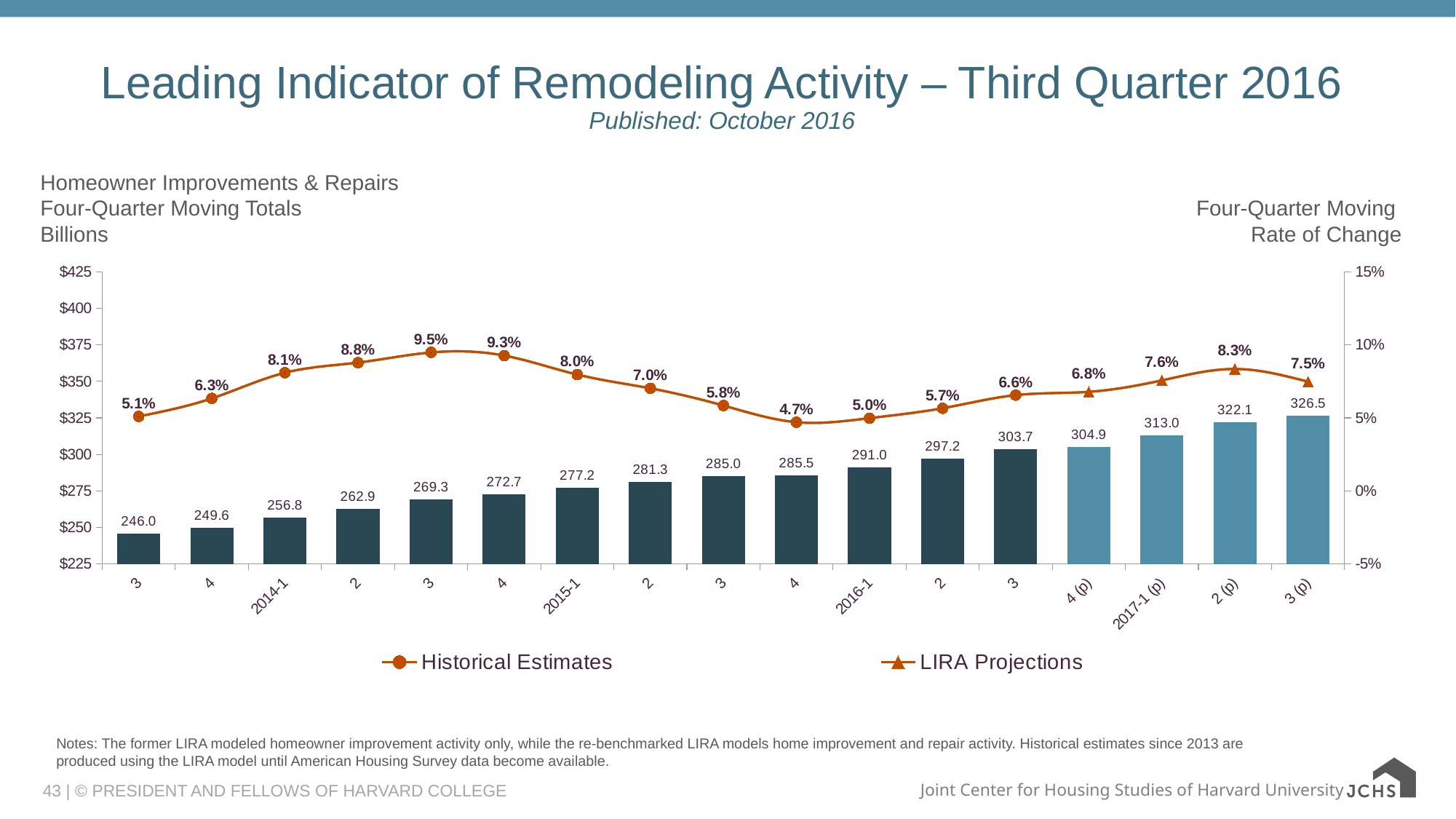
Which is larger, the rate of change for 2015-1 or for 2 (p)? 2 (p) Do the four-quarter moving totals rise or fall from left to right across the chart? rise How many series does the legend list? 2 What is the difference in four-quarter moving totals between 2017-1 (p) and 2016-1? 22.0 What is the rate of change shown for 2017-1 (p)? 7.6% How many bars are plotted in the chart? 17 What is the four-quarter moving total (in billions) for 2016-1? 291.0 Is the four-quarter moving total for 2015-1 greater or less than $275? greater What is the four-quarter moving rate of change for 2014-1? 8.1% What is the projected four-quarter moving total for 3 (p)? 326.5 Which period has the highest four-quarter moving rate of change? 2014-3 (9.5%) Which period has the lowest four-quarter moving rate of change? 2015-4 (4.7%)